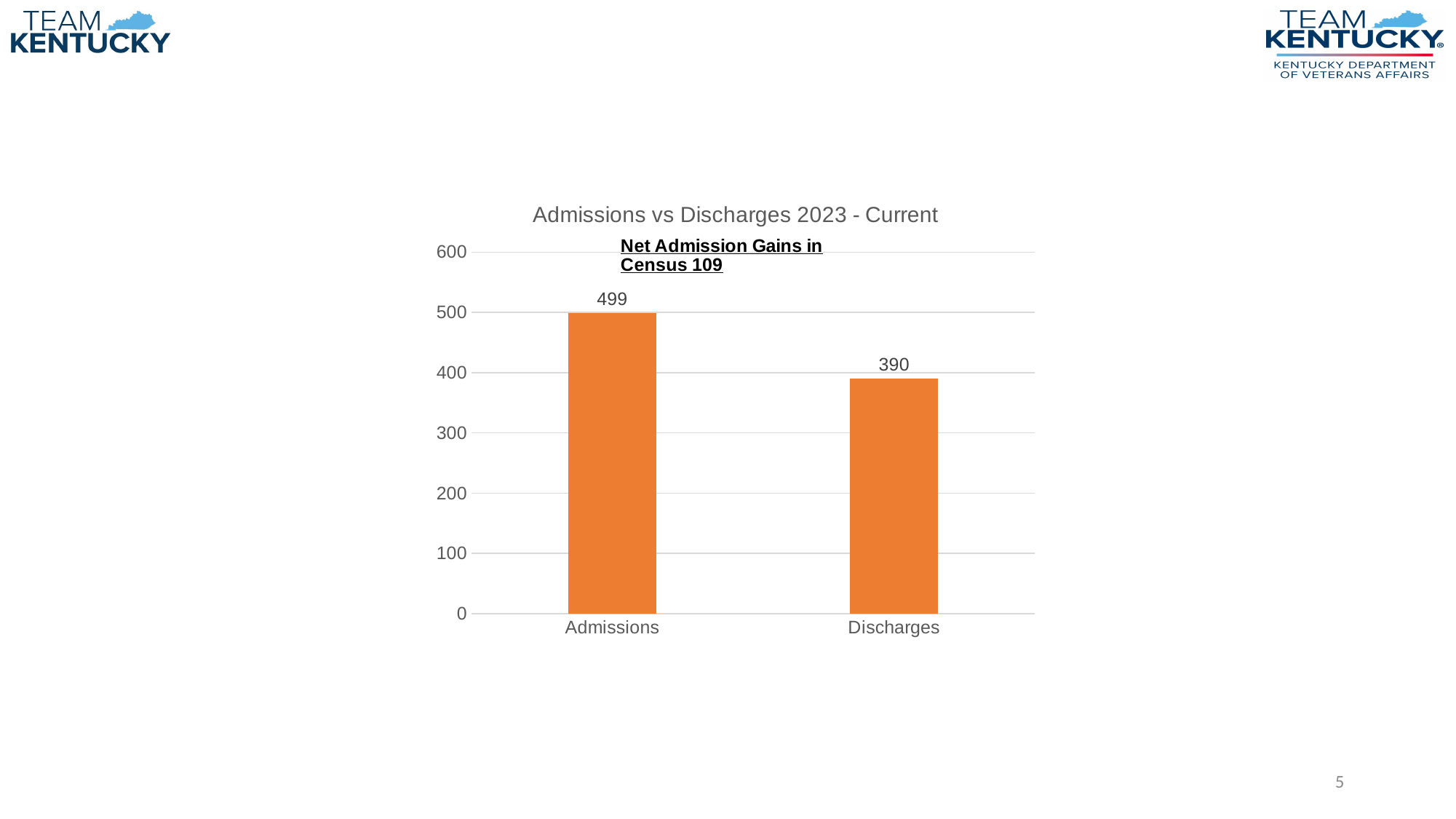
What kind of chart is shown on the slide? bar chart Is the value for Admissions greater or less than 400? greater Which category has the highest value? Admissions Which is larger, Admissions or Discharges? Admissions Which category has the lowest value? Discharges Is the value for Discharges greater or less than 400? less What net admission gain in census does the annotation on the chart state? 109 How many categories are shown on the chart? 2 What is the value for Admissions? 499 What is the difference between Admissions and Discharges? 109 What is the title of the chart? Admissions vs Discharges 2023 - Current What is the value for Discharges? 390